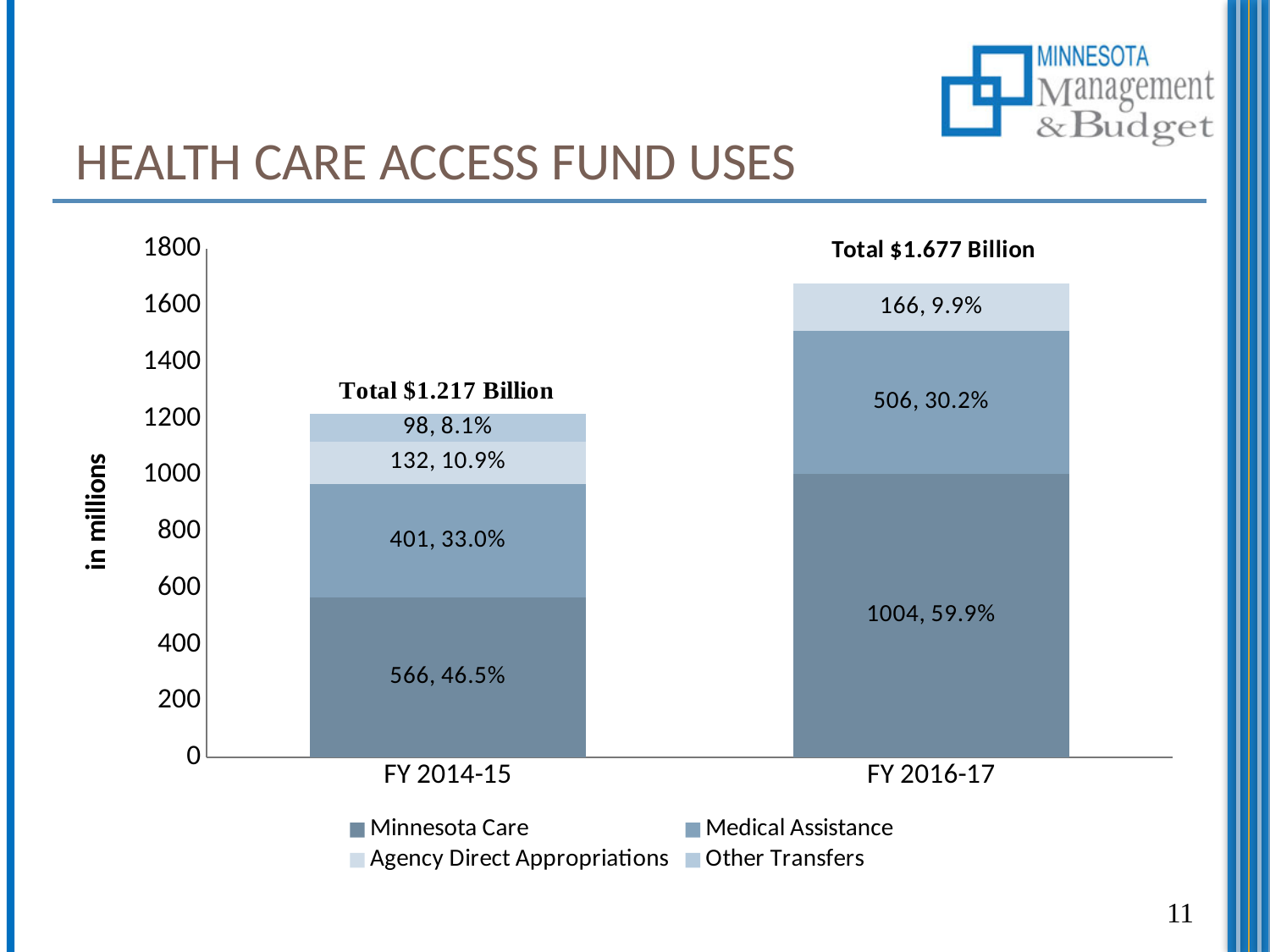
What is the total shown for the FY 2016-17 bar? $1.677 Billion What percentage share does Minnesota Care have in FY 2016-17? 59.9% What type of chart is shown on the slide? Stacked bar chart What percentage share does Medical Assistance have in FY 2014-15? 33.0% What is the value for Minnesota Care in FY 2014-15? 566 How many series does the legend list? 4 What is the value for Medical Assistance in FY 2016-17? 506 What is the value for Minnesota Care in FY 2016-17? 1004 What is the difference between the Minnesota Care values for FY 2016-17 and FY 2014-15? 438 What is the total shown for the FY 2014-15 bar? $1.217 Billion How many fiscal year categories are shown on the x axis? 2 Which fiscal year has the larger Medical Assistance value, FY 2014-15 or FY 2016-17? FY 2016-17